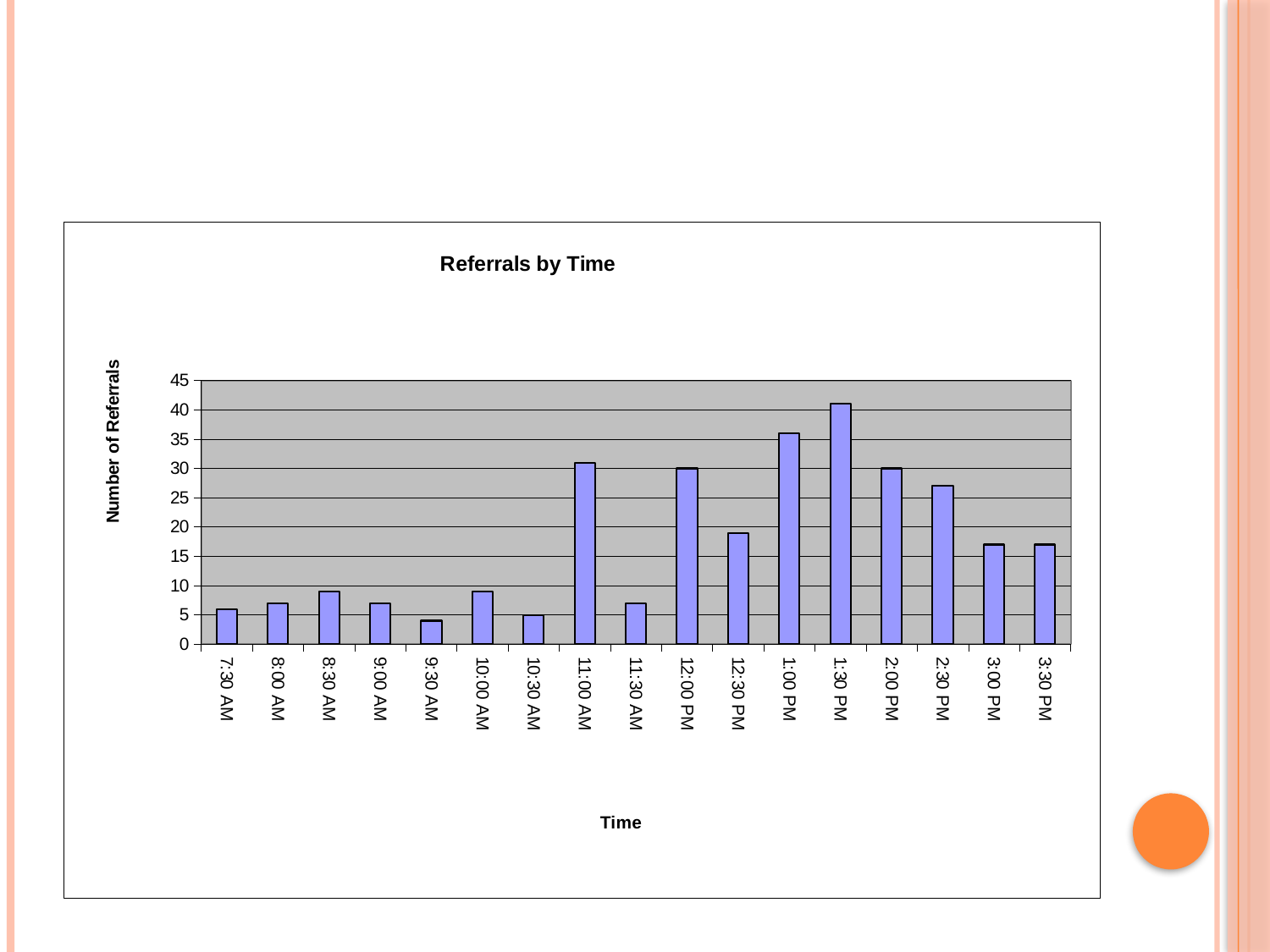
Which time has the lowest number of referrals? 9:30 AM Which has more referrals, 11:00 AM or 11:30 AM? 11:00 AM Is the value for 9:30 AM greater or less than 5? less How many time categories are shown on the x axis? 17 Is the value for 11:00 AM greater or less than 35? less What is the title of the chart? Referrals by Time Is the value for 1:30 PM greater or less than 40? greater What is the label of the vertical axis? Number of Referrals Which has more referrals, 1:00 PM or 2:30 PM? 1:00 PM Which time has the highest number of referrals? 1:30 PM What type of chart is shown on the slide? bar chart